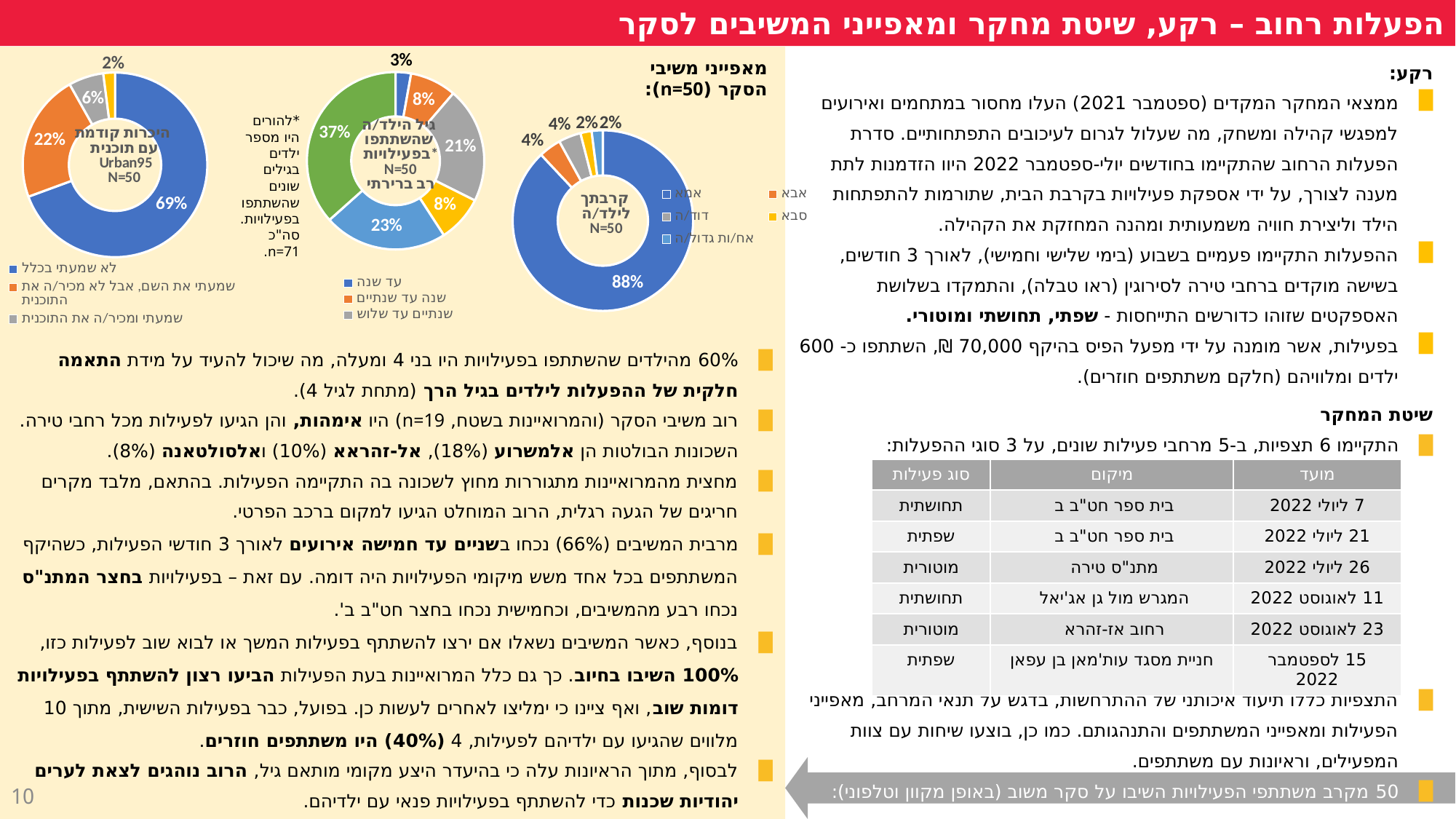
In the 'היכרות קודמת עם תוכנית Urban95' donut chart, which is larger: 'לא שמעתי בכלל' or 'שמעתי את השם, אבל לא מכיר/ה את התוכנית'? לא שמעתי בכלל In the 'גיל הילד/ה שהשתתפו בפעילויות' donut chart, what percentage is shown for 'שנתיים עד שלוש'? 21% In the 'קרבתך לילד/ה' donut chart, what percentage is shown for 'אמא'? 88% In the 'גיל הילד/ה שהשתתפו בפעילויות' donut chart, what is the difference between the 'שנתיים עד שלוש' share and the 'שנה עד שנתיים' share? 13% In the 'קרבתך לילד/ה' donut chart, which category has the largest share? אמא In the 'היכרות קודמת עם תוכנית Urban95' donut chart, what is the difference between the 'לא שמעתי בכלל' share and the 'שמעתי את השם, אבל לא מכיר/ה את התוכנית' share? 47% In the 'גיל הילד/ה שהשתתפו בפעילויות' donut chart, what percentage is shown for 'עד שנה'? 3% In the 'קרבתך לילד/ה' donut chart, what is the sample size (N) shown in the centre? N=50 In the 'היכרות קודמת עם תוכנית Urban95' donut chart, what percentage is shown for 'לא שמעתי בכלל'? 69% What type of chart is used for 'היכרות קודמת עם תוכנית Urban95'? Donut (pie) chart In the 'היכרות קודמת עם תוכנית Urban95' donut chart, what percentage is shown for 'שמעתי ומכיר/ה את התוכנית'? 6% In the 'גיל הילד/ה שהשתתפו בפעילויות' donut chart, what is the largest percentage shown? 37%